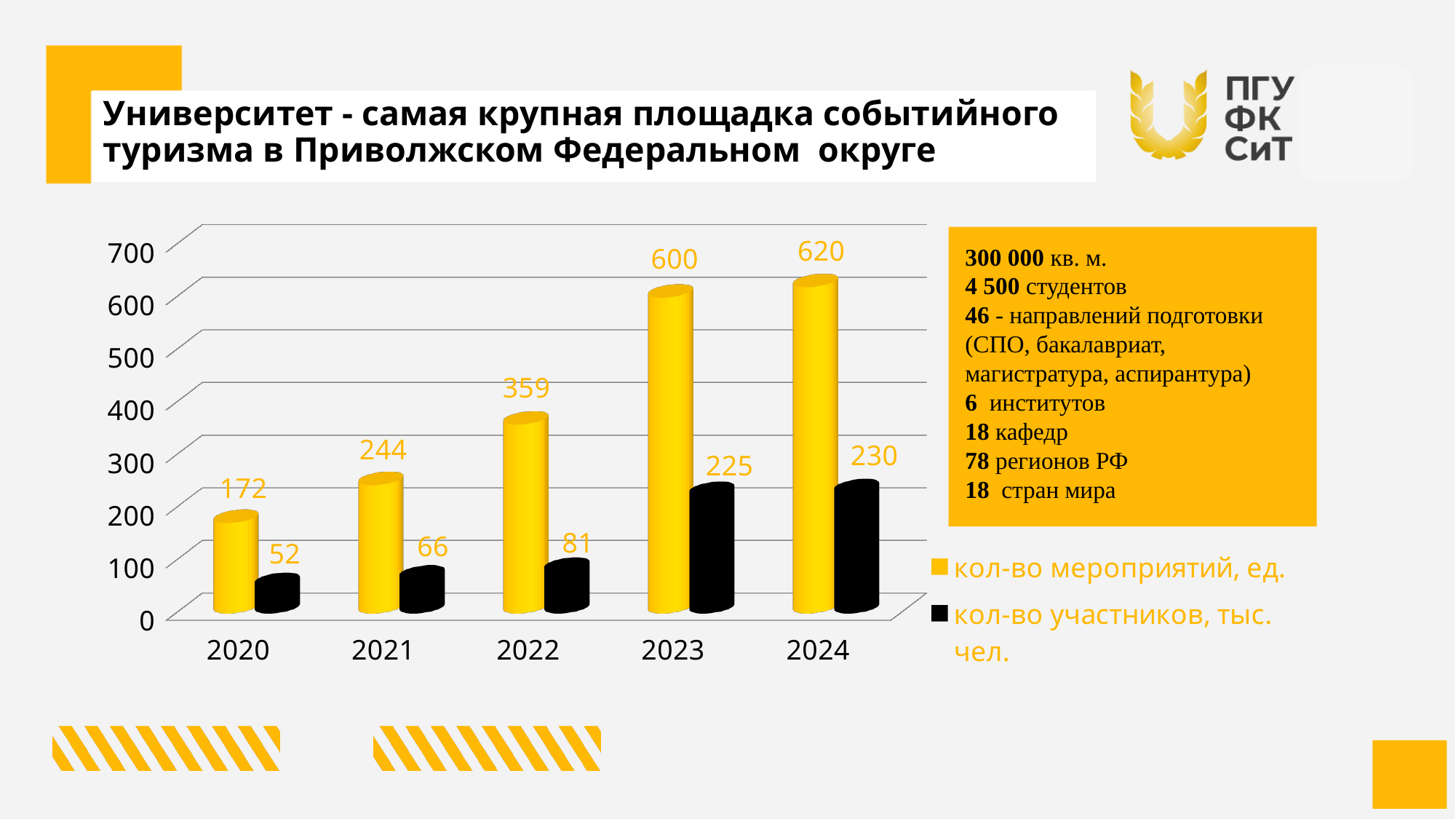
What is the number of events (кол-во мероприятий, ед.) in 2022? 359 Does the number of events rise or fall from 2020 to 2024? rise What is the number of events (кол-во мероприятий, ед.) in 2020? 172 What kind of chart is shown on the slide? bar chart Is the number of events in 2021 greater or less than 300? less Which is larger: the number of participants in 2021 or in 2022? 2022 Which year has the highest number of events (кол-во мероприятий, ед.)? 2024 How many series does the chart legend list? 2 What is the difference between the number of events in 2023 and in 2022? 241 What is the number of participants (кол-во участников, тыс. чел.) in 2023? 225 How many years are shown on the x axis of the chart? 5 Which year has the lowest number of participants (кол-во участников, тыс. чел.)? 2020